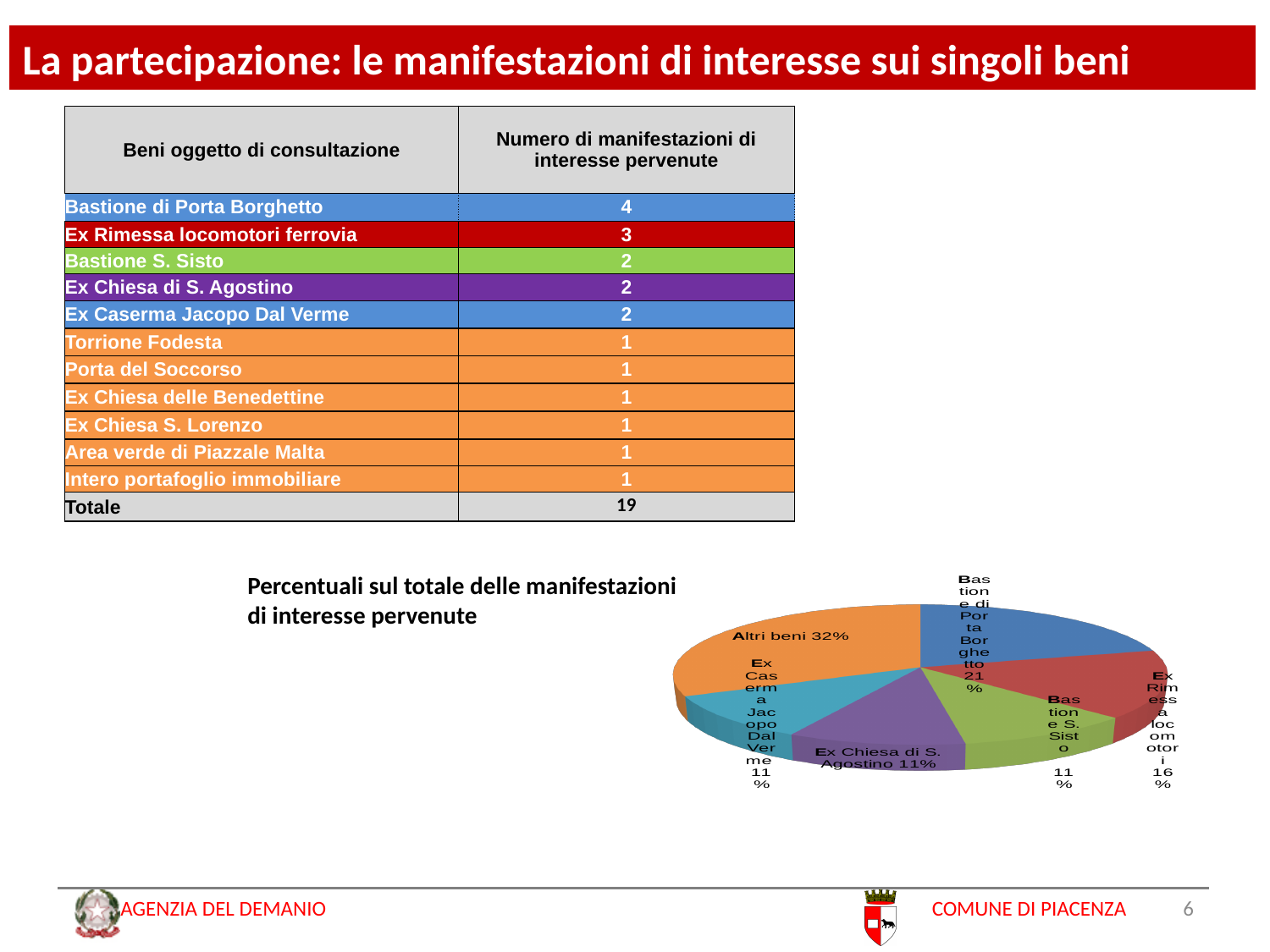
What percentage does the pie chart show for Bastione di Porta Borghetto? 21% What is the difference in percentage points between Bastione di Porta Borghetto and Ex Rimessa locomotori in the pie chart? 5 What is the difference in percentage points between Altri beni and Bastione di Porta Borghetto in the pie chart? 11 What percentage does the pie chart show for Ex Caserma Jacopo Dal Verme? 11% How many slices does the pie chart have? 6 What kind of chart is shown on the slide? pie chart In the pie chart, which is larger: Ex Rimessa locomotori or Bastione S. Sisto? Ex Rimessa locomotori Which slice of the pie chart is the largest? Altri beni What percentage does the pie chart show for Altri beni? 32% What is the title of the pie chart? Percentuali sul totale delle manifestazioni di interesse pervenute What percentage does the pie chart show for Ex Chiesa di S. Agostino? 11% What percentage does the pie chart show for Ex Rimessa locomotori? 16%